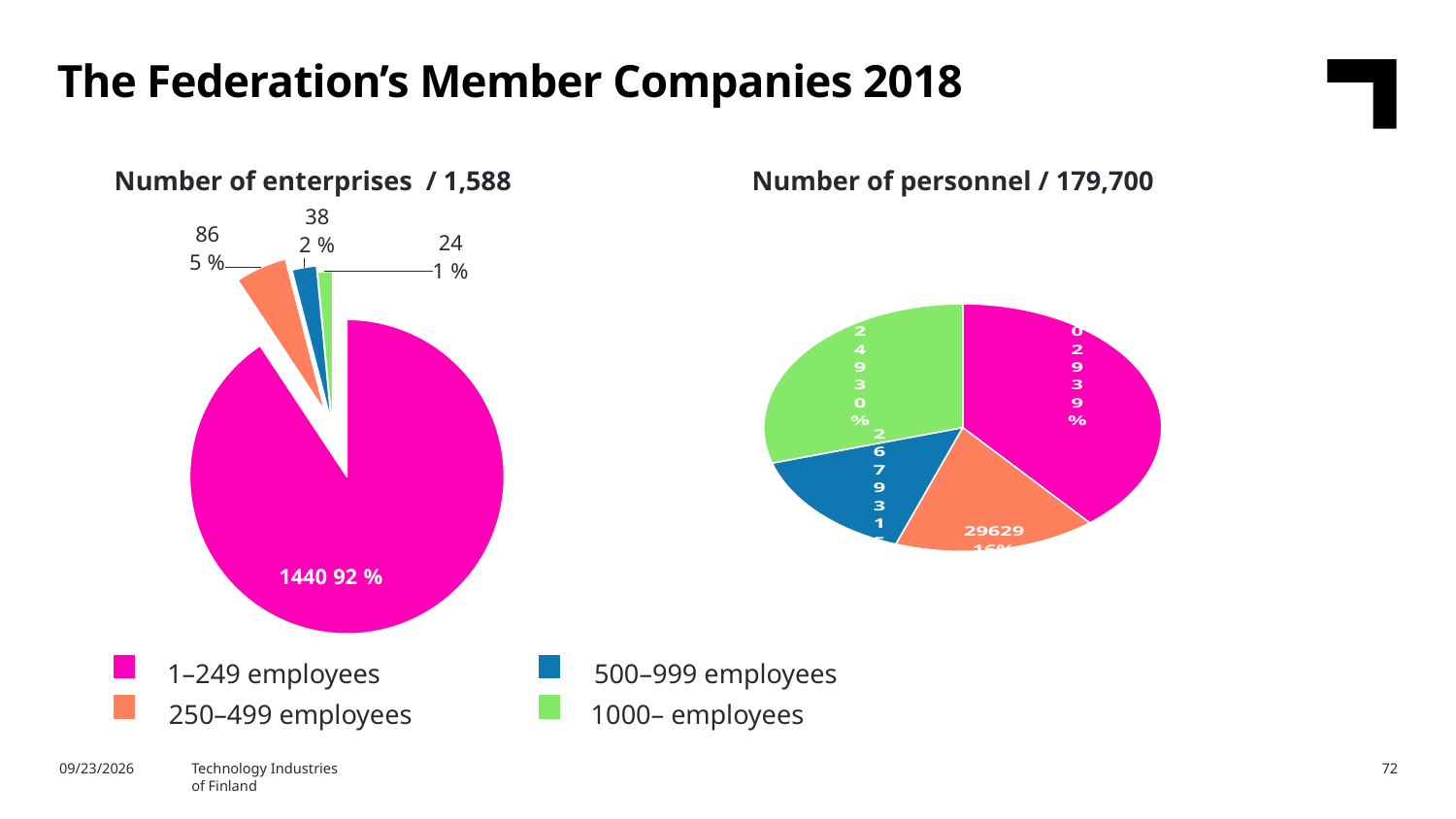
On the 'Number of enterprises' chart, which employee size class has the fewest enterprises? 1000– employees On the 'Number of enterprises' chart, what share of enterprises have 1–249 employees? 92 % On the 'Number of enterprises' chart, how many enterprises have 250–499 employees? 86 How many slices does the 'Number of enterprises' pie chart have? 4 On the 'Number of personnel' chart, which employee size class accounts for the largest share of personnel? 1–249 employees On the 'Number of enterprises' chart, how many enterprises have 1000 or more employees? 24 On the 'Number of enterprises' chart, what is the difference between the number of enterprises with 250–499 employees and those with 500–999 employees? 48 What type of chart is used for 'Number of personnel / 179,700'? Pie chart Which colour represents the 250–499 employees category in the legend? Orange On the 'Number of enterprises' chart, which is larger: the number of enterprises with 500–999 employees or with 1000– employees? 500–999 employees On the 'Number of enterprises' chart, which employee size class has the most enterprises? 1–249 employees On the 'Number of enterprises' chart, how many member companies have 1–249 employees? 1440